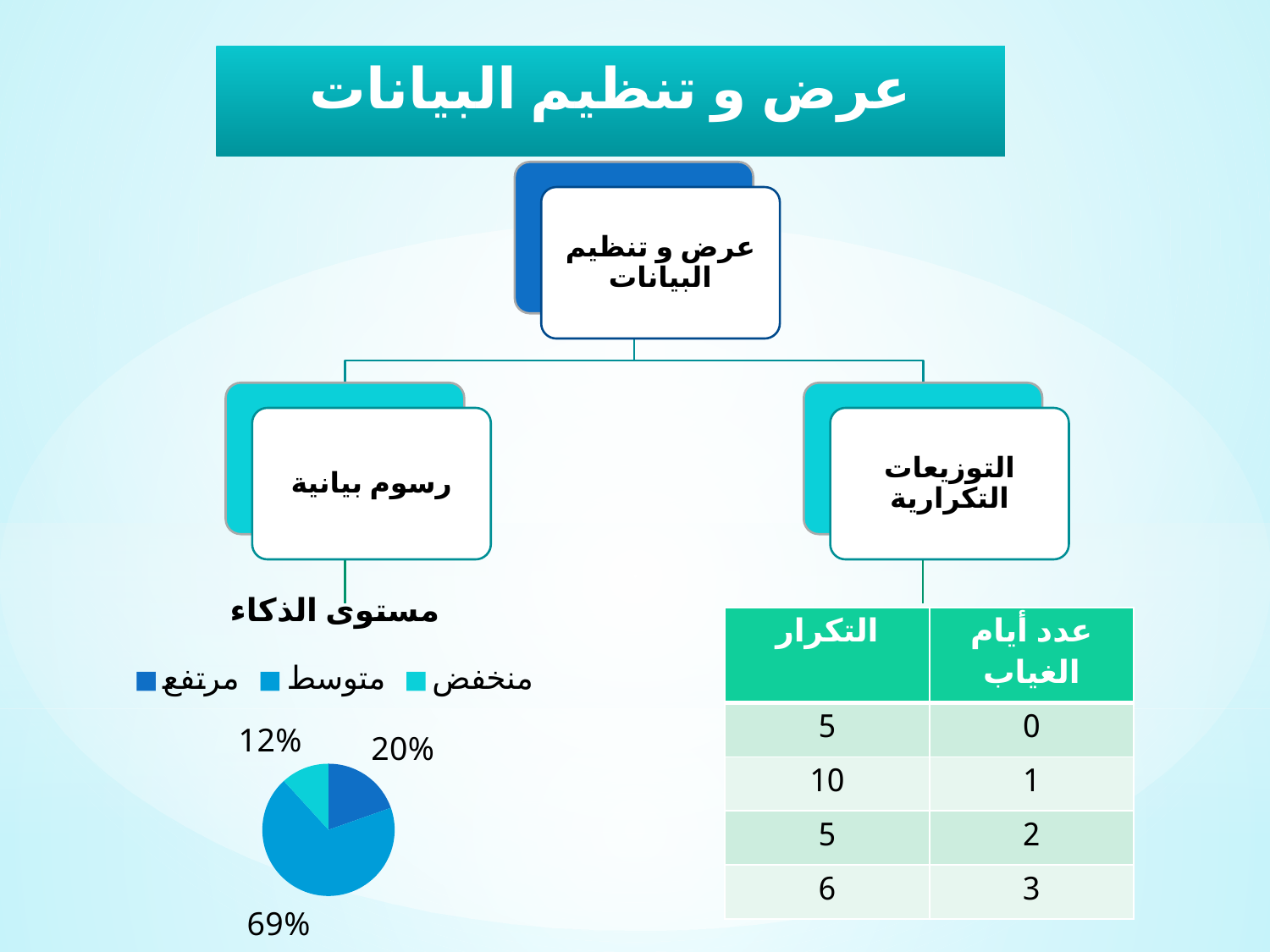
In the pie chart مستوى الذكاء, what is the difference in percentage points between the مرتفع and منخفض slices? 8 In the pie chart مستوى الذكاء, what share is labelled for the مرتفع slice? 20% In the pie chart مستوى الذكاء, what share is labelled for the منخفض slice? 12% In the pie chart مستوى الذكاء, which category has the largest slice? متوسط How many slices does the pie chart مستوى الذكاء have? 3 What is the title of the pie chart on the slide? مستوى الذكاء In the pie chart مستوى الذكاء, which category has the smallest slice? منخفض How many entries does the legend of the pie chart مستوى الذكاء list? 3 What kind of chart is shown under the heading مستوى الذكاء? pie chart In the pie chart مستوى الذكاء, which is larger, the مرتفع slice or the منخفض slice? مرتفع In the pie chart مستوى الذكاء, what is the difference in percentage points between the متوسط and مرتفع slices? 49 In the pie chart مستوى الذكاء, what share is labelled for the متوسط slice? 69%